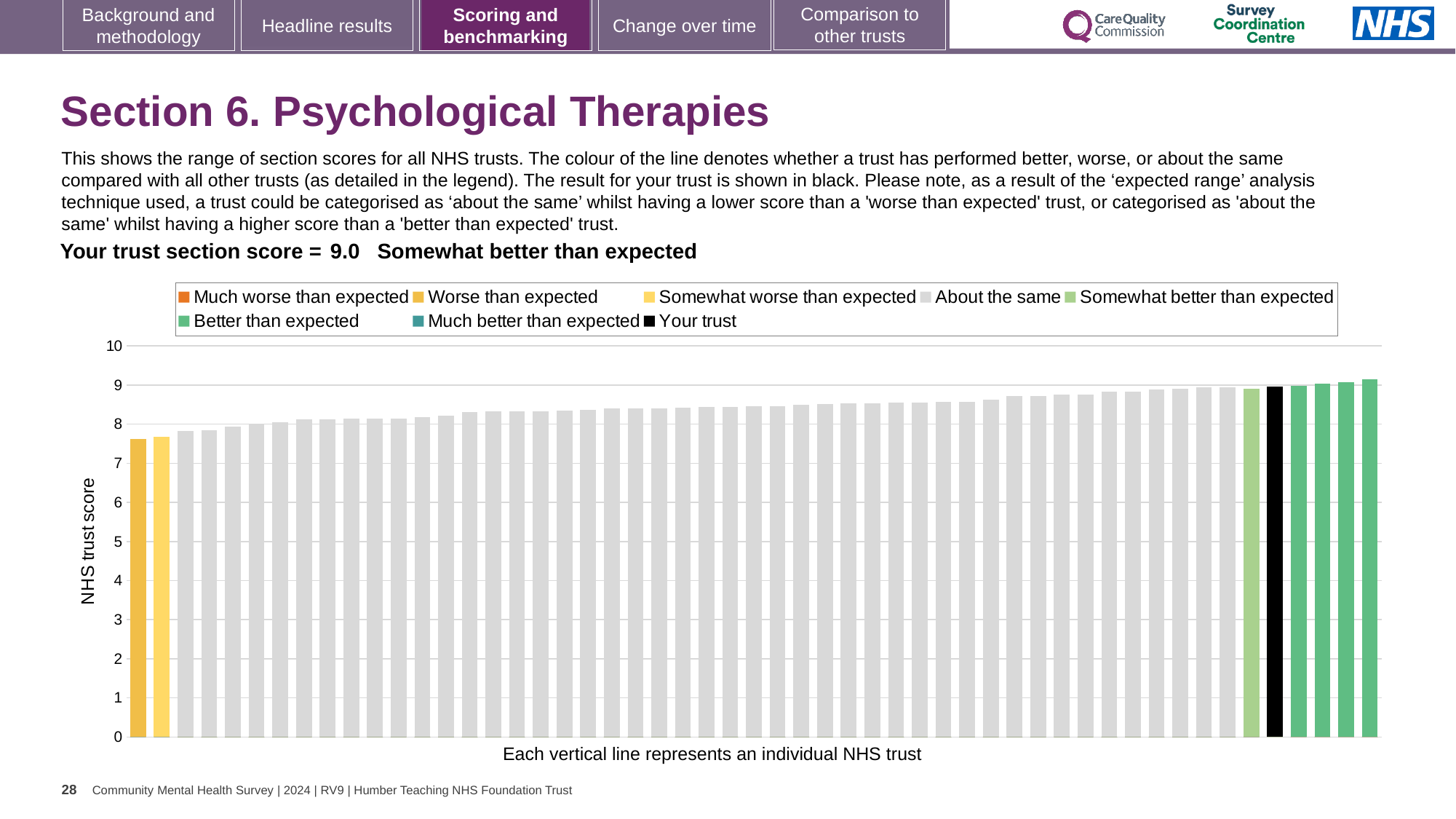
How many entries does the chart legend list? 8 Which legend category does the highest bar on the chart belong to? Better than expected Is the value of the black 'Your trust' bar greater or less than 8? greater Is the value of the leftmost (lowest) bar greater or less than 8? less Do the bar values rise or fall from left to right along the x axis? rise What is the label on the vertical axis of the chart? NHS trust score What is the highest value shown on the vertical axis? 10 What kind of chart is shown on the slide? bar chart Is the value of the leftmost (lowest) bar greater or less than 7? greater Which legend category does the trust's own score fall into? Somewhat better than expected How many bars are coloured as 'Better than expected'? 4 What is the trust's section score for Section 6 Psychological Therapies? 9.0